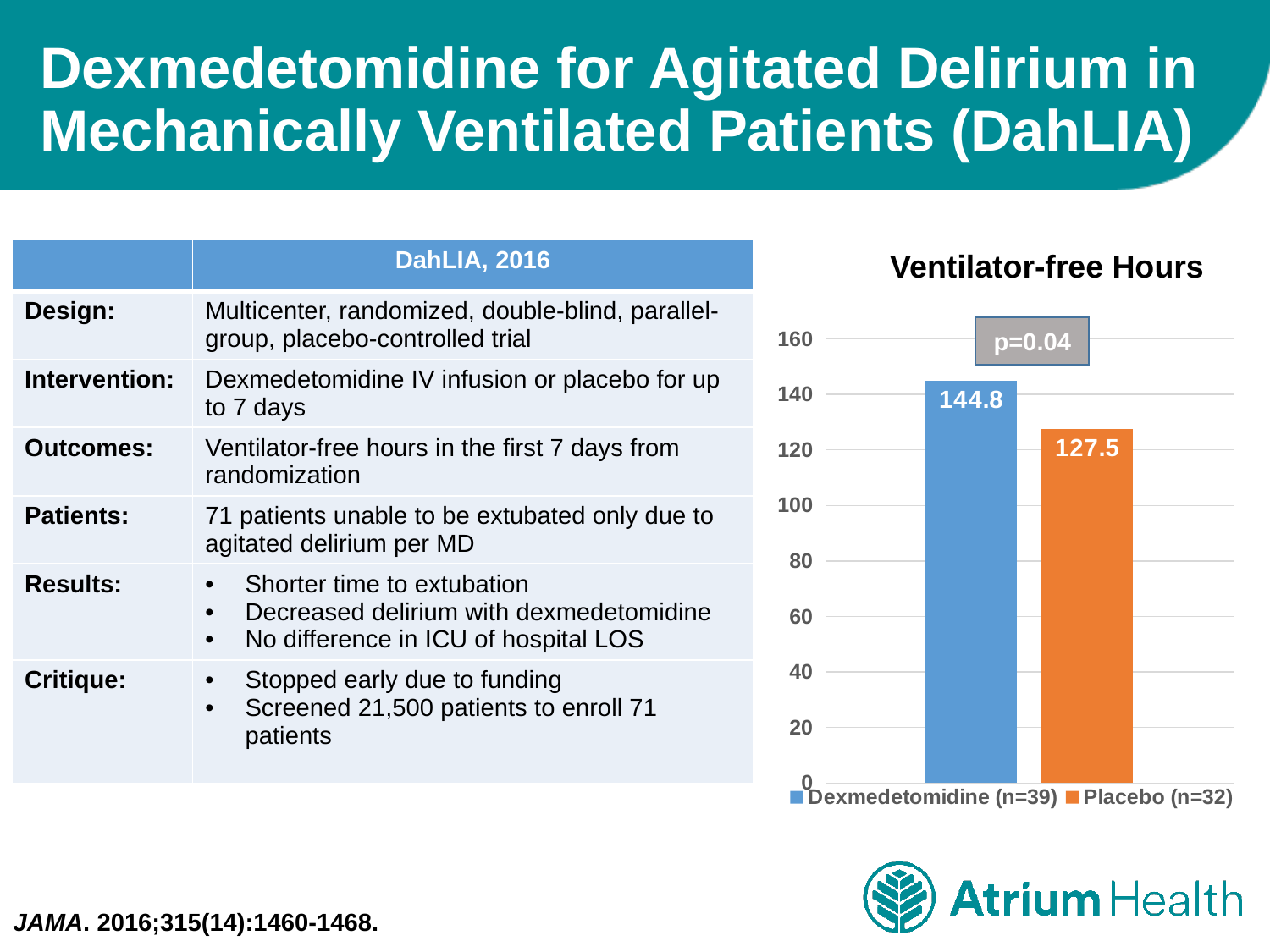
How many series does the legend of the Ventilator-free Hours chart list? 2 What is the title of the chart on the slide? Ventilator-free Hours Is the value for Dexmedetomidine (n=39) greater or less than 140? greater What kind of chart is the Ventilator-free Hours chart? bar chart What is the value for Placebo (n=32) in the Ventilator-free Hours chart? 127.5 Which series has the lowest value in the Ventilator-free Hours chart? Placebo (n=32) Is the value for Placebo (n=32) greater or less than 140? less What p-value is shown on the Ventilator-free Hours chart? p=0.04 What is the value for Dexmedetomidine (n=39) in the Ventilator-free Hours chart? 144.8 What is the difference between the Dexmedetomidine (n=39) and Placebo (n=32) values in the Ventilator-free Hours chart? 17.3 Which series has the highest value in the Ventilator-free Hours chart? Dexmedetomidine (n=39) Which is larger in the Ventilator-free Hours chart, Dexmedetomidine (n=39) or Placebo (n=32)? Dexmedetomidine (n=39)